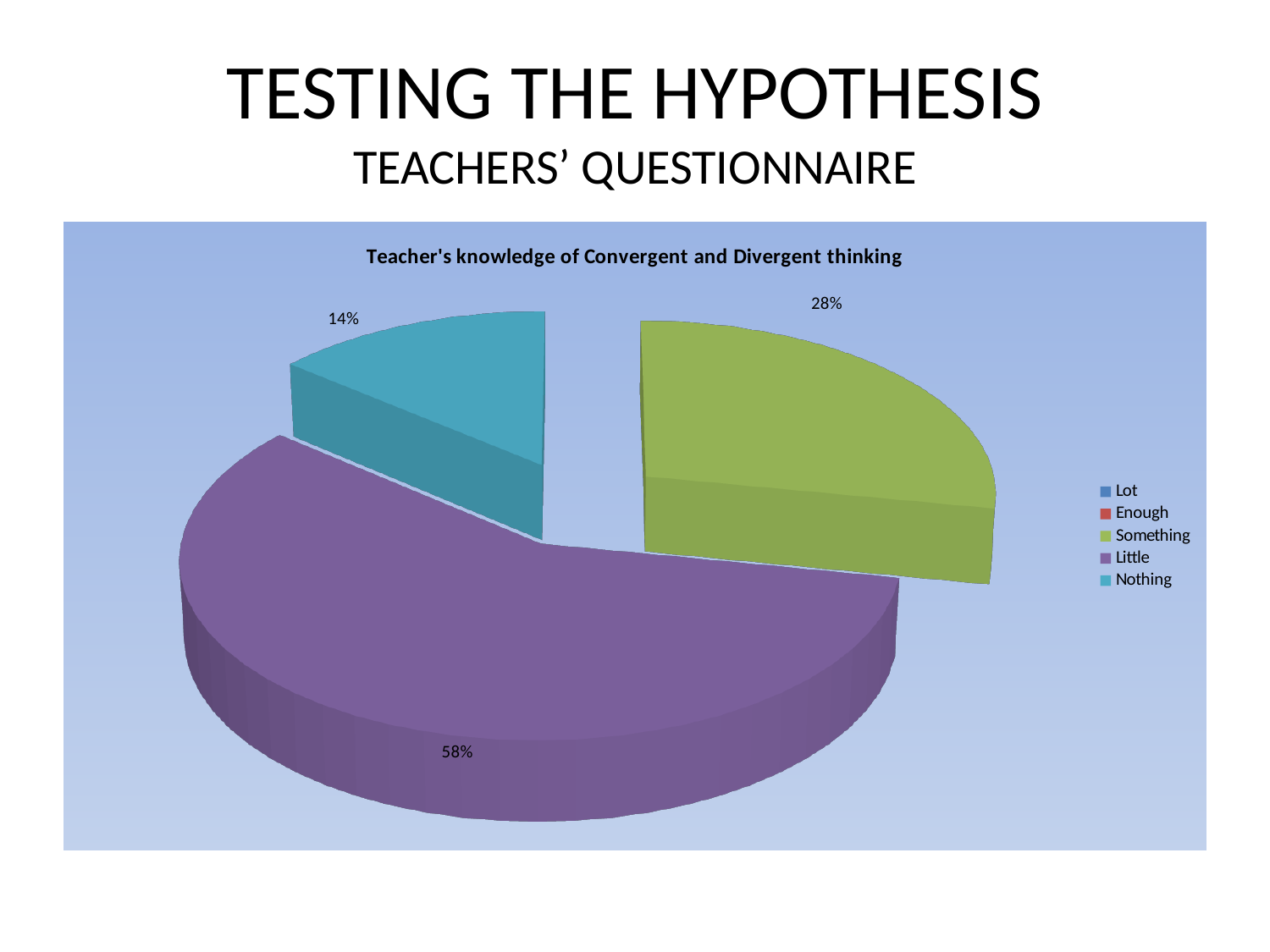
Which is larger, the Something slice or the Nothing slice? Something What percentage is shown for the Something slice? 28% What is the difference between the Something slice and the Nothing slice? 14% How many slices are visible in the pie? 3 What percentage is shown for the Nothing slice? 14% How many entries does the legend list? 5 What kind of chart is shown on the slide? Pie chart What is the title of the chart? Teacher's knowledge of Convergent and Divergent thinking Which of the labelled slices is the smallest? Nothing What percentage of the pie is labelled for the Little slice? 58% Which category has the largest slice of the pie? Little What is the difference between the Little slice and the Something slice? 30%